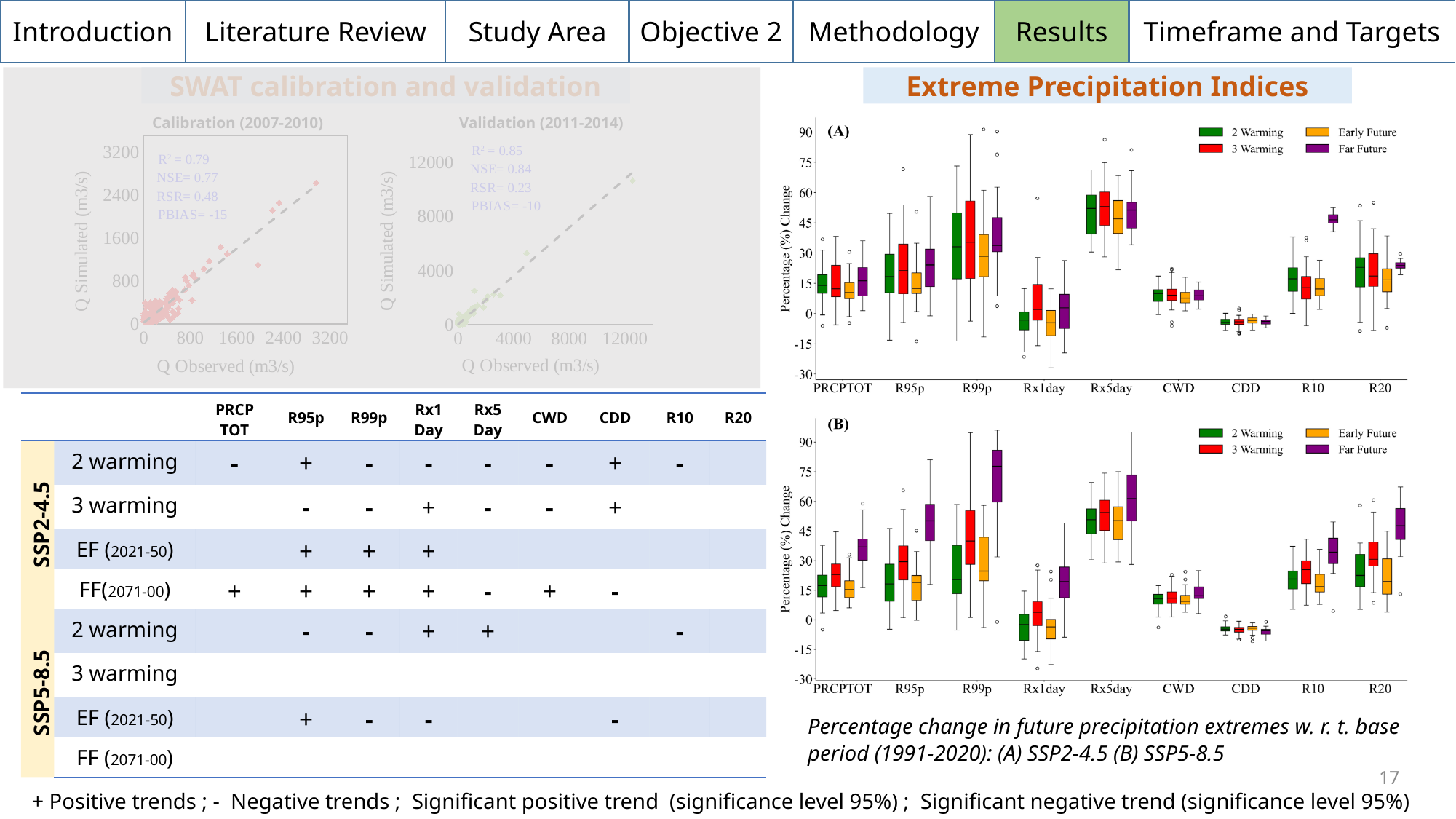
In chart (B), which index has the highest Far Future median? R99p How many precipitation indices are shown along the x axis of chart (A)? 9 What kind of chart is chart (A) under the title 'Extreme Precipitation Indices'? Box plot In chart (A), is the median of the 2 Warming box for CDD greater or less than 15? less How many series does the legend of chart (B) list? 4 What is the y-axis label of chart (A)? Percentage (%) Change In the SWAT calibration (2007-2010) scatter chart, what R² value is printed? 0.79 In chart (A), is the median of the Far Future box for R10 greater or less than 30? greater In the SWAT validation (2011-2014) scatter chart, what NSE value is printed? 0.84 In chart (A), which is larger: the 3 Warming median for Rx5day or the 3 Warming median for CWD? Rx5day In chart (B), is the median of the Far Future box for R99p greater or less than 60? greater In chart (B), which series is drawn in purple? Far Future